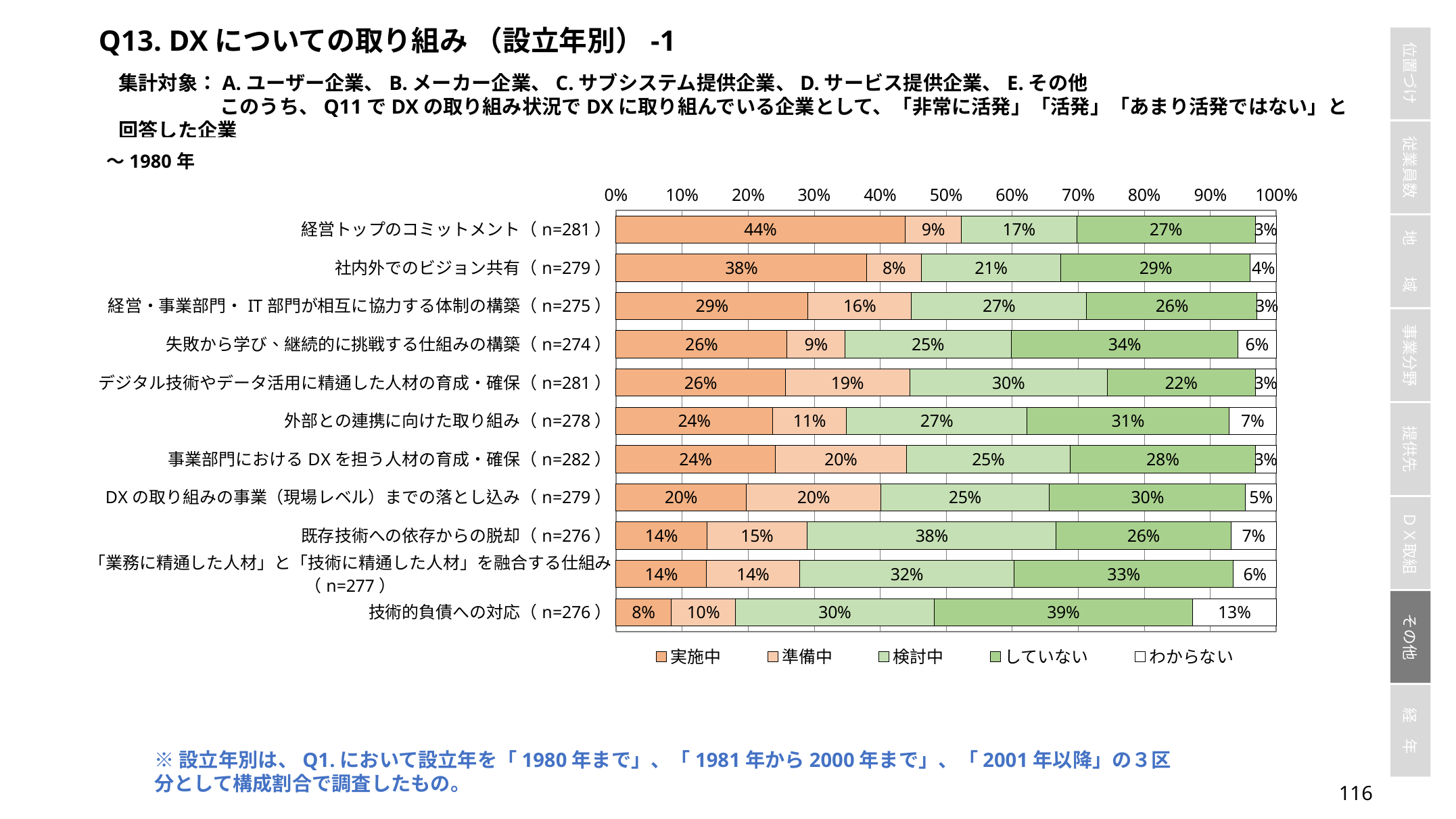
How many categories (items) are plotted in the chart? 11 What kind of chart is shown on the slide? Stacked bar chart What is the 検討中 value for 既存技術への依存からの脱却 (n=276)? 38% What is the していない value for 技術的負債への対応 (n=276)? 39% Which category has the highest 実施中 value? 経営トップのコミットメント (n=281) What is the difference between the 実施中 values for 経営トップのコミットメント (n=281) and 社内外でのビジョン共有 (n=279)? 6% What is the 実施中 value for 経営トップのコミットメント (n=281)? 44% What is the わからない value for 技術的負債への対応 (n=276)? 13% Which category has the lowest 実施中 value? 技術的負債への対応 (n=276) How many series does the legend list? 5 Which legend entry is shown in the darkest green colour? していない Which is larger: the 準備中 value for 事業部門におけるDXを担う人材の育成・確保 (n=282) or for 外部との連携に向けた取り組み (n=278)? 事業部門におけるDXを担う人材の育成・確保 (n=282)